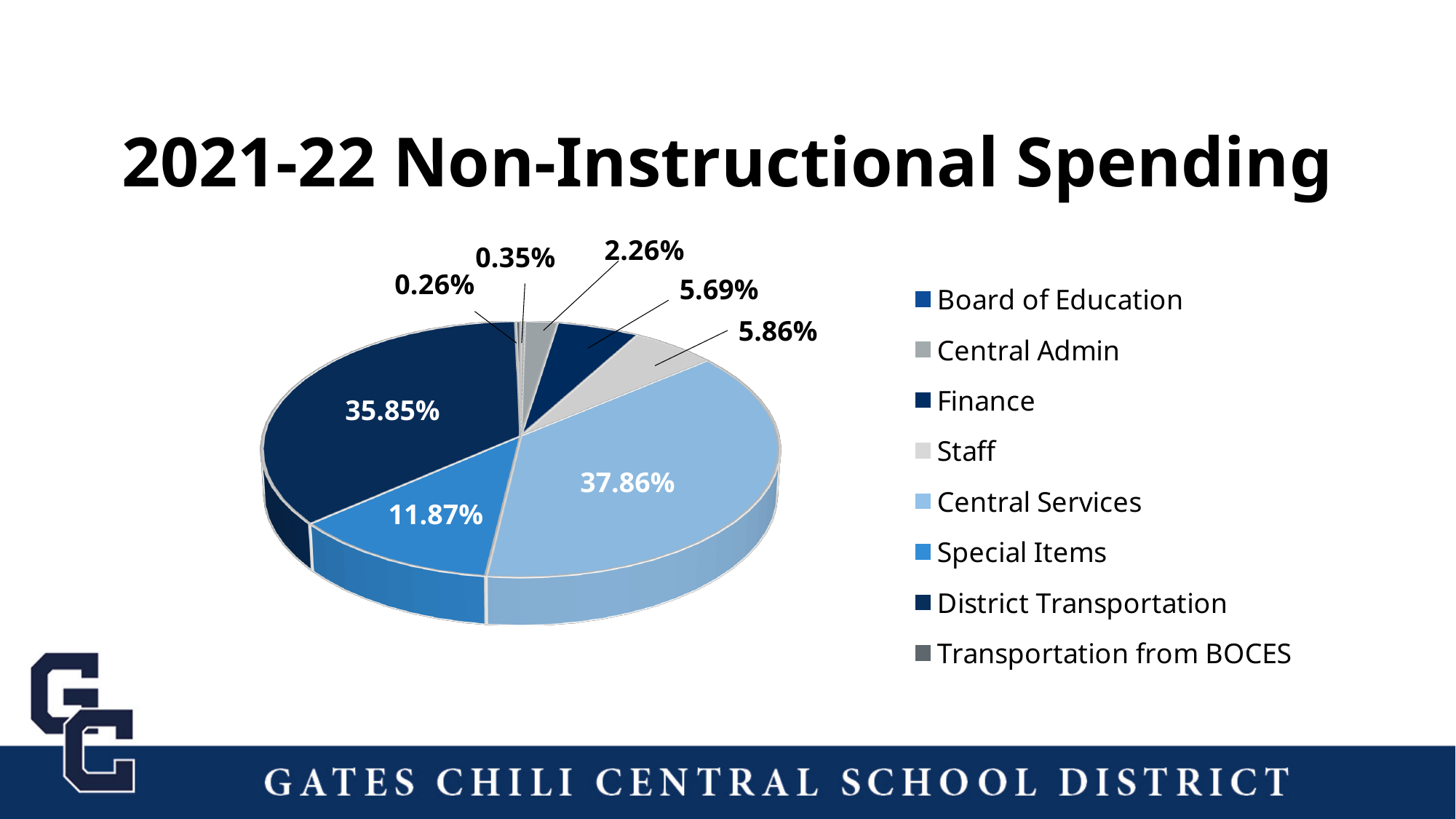
What percentage of non-instructional spending is Central Services? 37.86% What is the smallest percentage shown on the pie chart? 0.26% What percentage of non-instructional spending is Central Admin? 2.26% By how many percentage points does Central Services exceed District Transportation? 2.01% How many categories does the legend of the pie chart list? 8 What percentage of non-instructional spending is Staff? 5.86% What percentage of non-instructional spending is District Transportation? 35.85% Which category has the largest share of the pie? Central Services What percentage of non-instructional spending is Special Items? 11.87% What kind of chart is shown on the slide? pie chart What percentage of non-instructional spending is Finance? 5.69% What is the title of the chart on the slide? 2021-22 Non-Instructional Spending